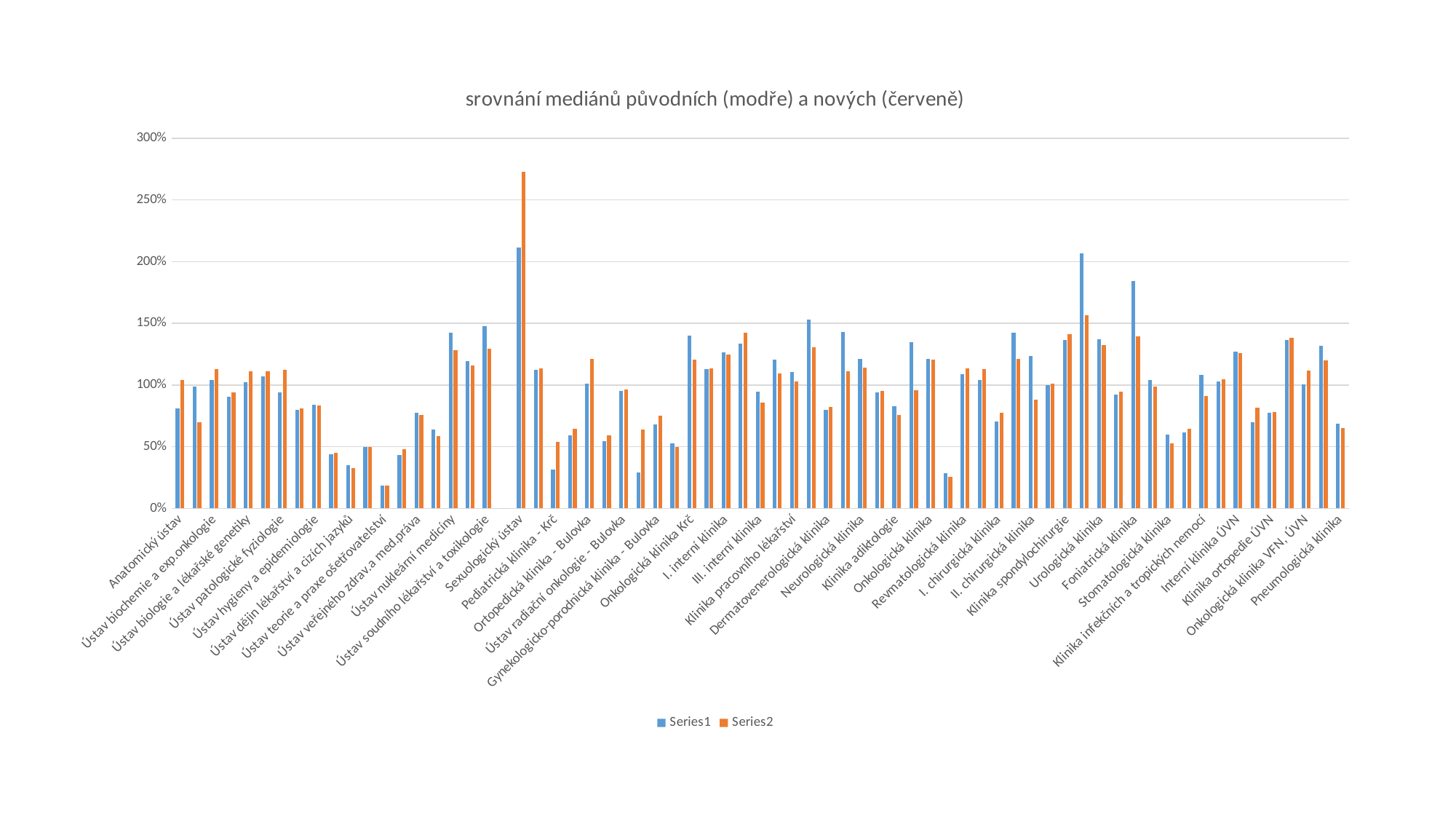
How many series does the legend list? 2 What are the names of the two series in the legend? Series1 and Series2 Is the Series2 value for Sexuologický ústav greater or less than 250%? greater What kind of chart is shown on the slide? bar chart What is the title of the chart? srovnání mediánů původních (modře) a nových (červeně) Is the Series1 value for Anatomický ústav greater or less than 100%? less What is the highest value shown on the vertical axis? 300% For Sexuologický ústav, which series has the larger value, Series1 or Series2? Series2 Which category has the highest Series2 value? Sexuologický ústav Is the Series1 value for Pneumologická klinika greater or less than 100%? less For Anatomický ústav, which series has the larger value, Series1 or Series2? Series2